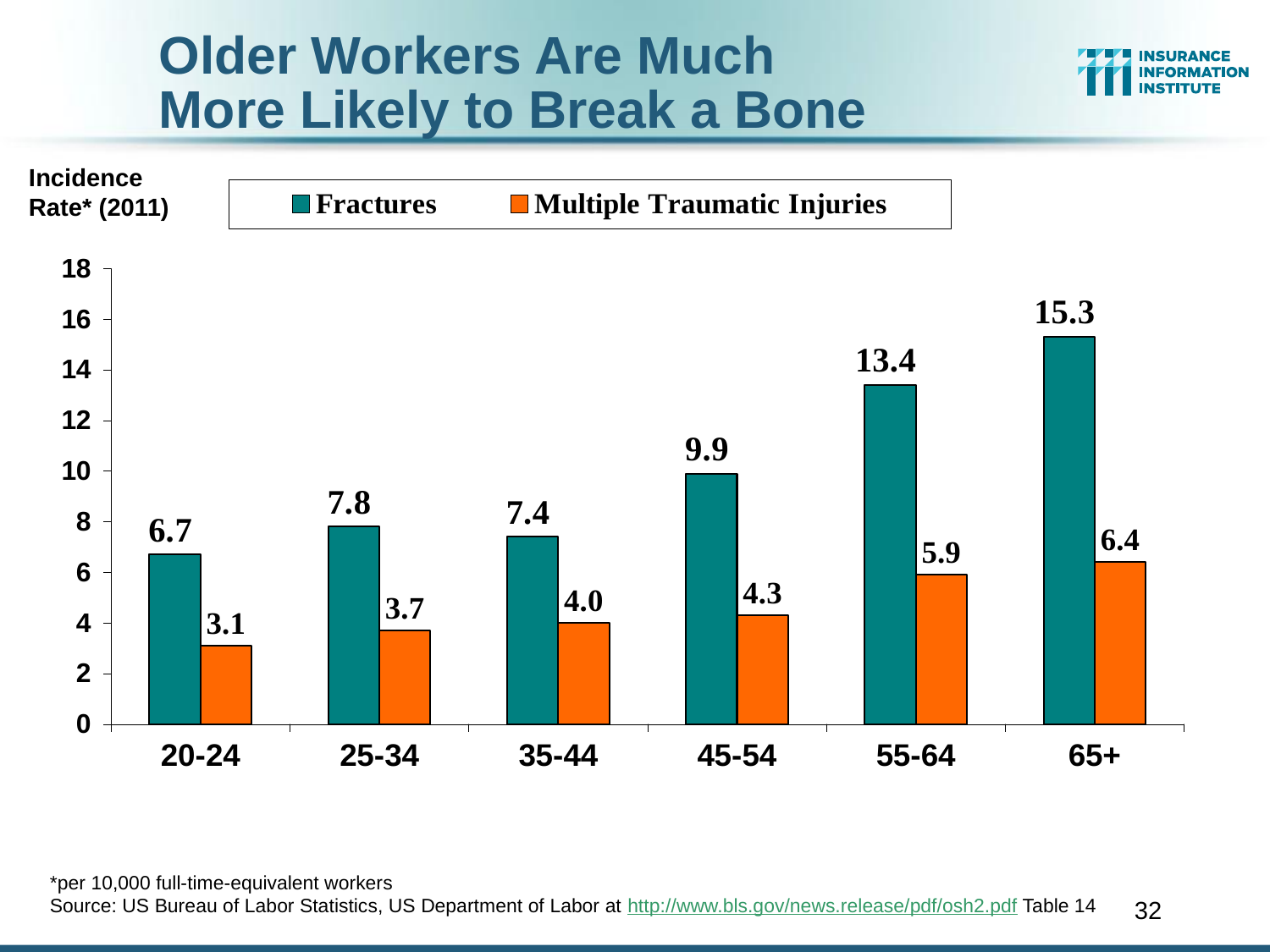
What colour are the Multiple Traumatic Injuries bars? orange Which age group has the lowest Multiple Traumatic Injuries incidence rate? 20-24 How many series does the legend list? 2 Is the Fractures rate for the 45-54 age group greater or less than 10? less How many age groups are shown on the x axis? 6 What is the Fractures incidence rate for the 65+ age group? 15.3 Which is larger: the Fractures rate for 25-34 or the Fractures rate for 35-44? 25-34 Which age group has the highest Fractures incidence rate? 65+ What is the Fractures incidence rate for the 35-44 age group? 7.4 What is the Multiple Traumatic Injuries incidence rate for the 20-24 age group? 3.1 What is the difference between the Fractures rate and the Multiple Traumatic Injuries rate for the 55-64 age group? 7.5 What kind of chart is shown on the slide? bar chart